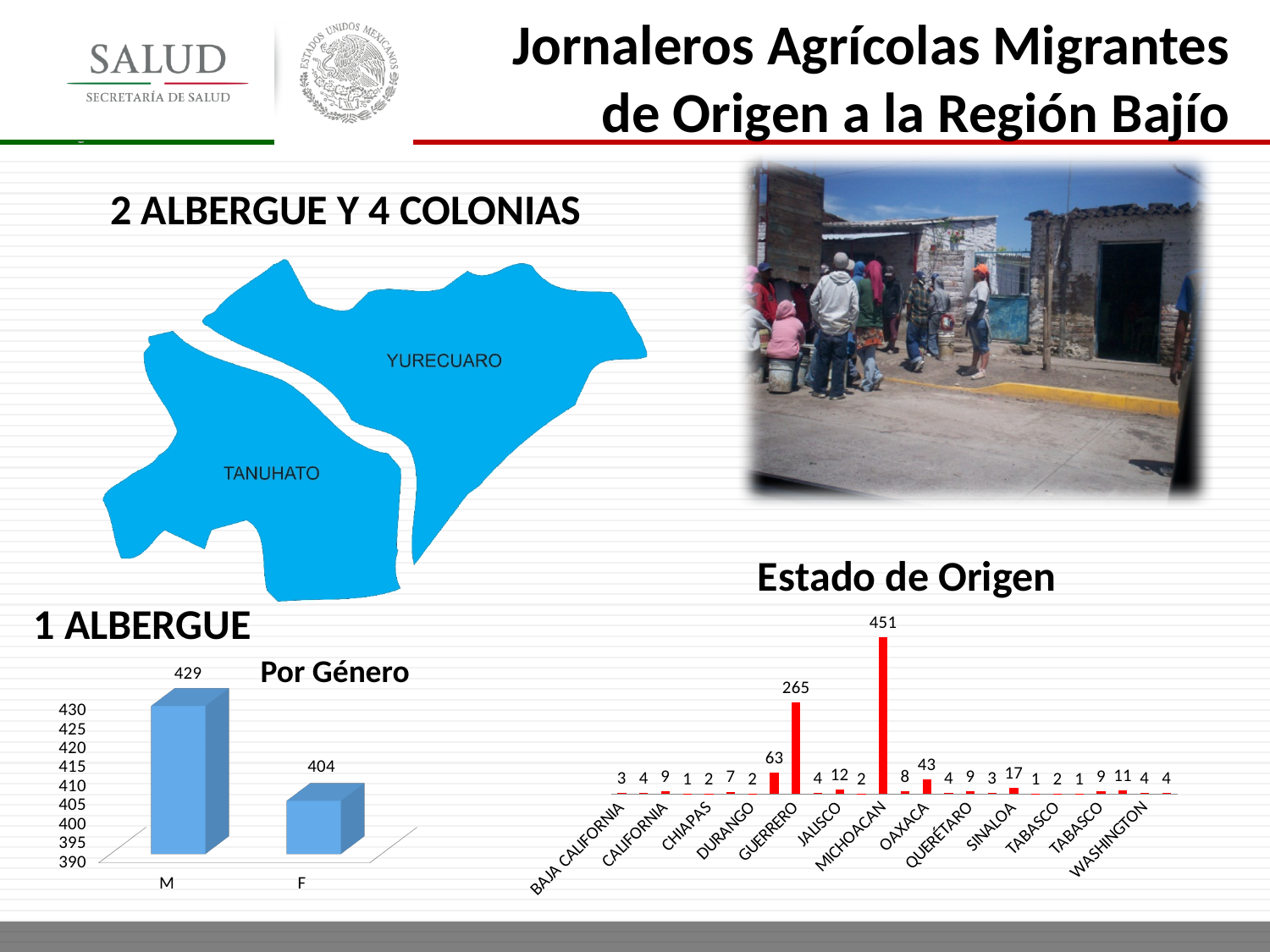
In the 'Por Género' chart, what is the value for M? 429 In the 'Por Género' chart, which category has the larger value, M or F? M What kind of chart is the 'Estado de Origen' chart? bar chart In the 'Estado de Origen' chart, what is the highest value shown? 451 In the 'Por Género' chart, what is the difference between the values for M and F? 25 In the 'Por Género' chart, how many categories are shown? 2 In the 'Estado de Origen' chart, what is the difference between the two highest values, 451 and 265? 186 In the 'Estado de Origen' chart, what is the second highest value shown? 265 What colour are the bars in the 'Estado de Origen' chart? red What kind of chart is the 'Por Género' chart? bar chart In the 'Estado de Origen' chart, which state has the highest value? MICHOACAN In the 'Por Género' chart, what is the value for F? 404